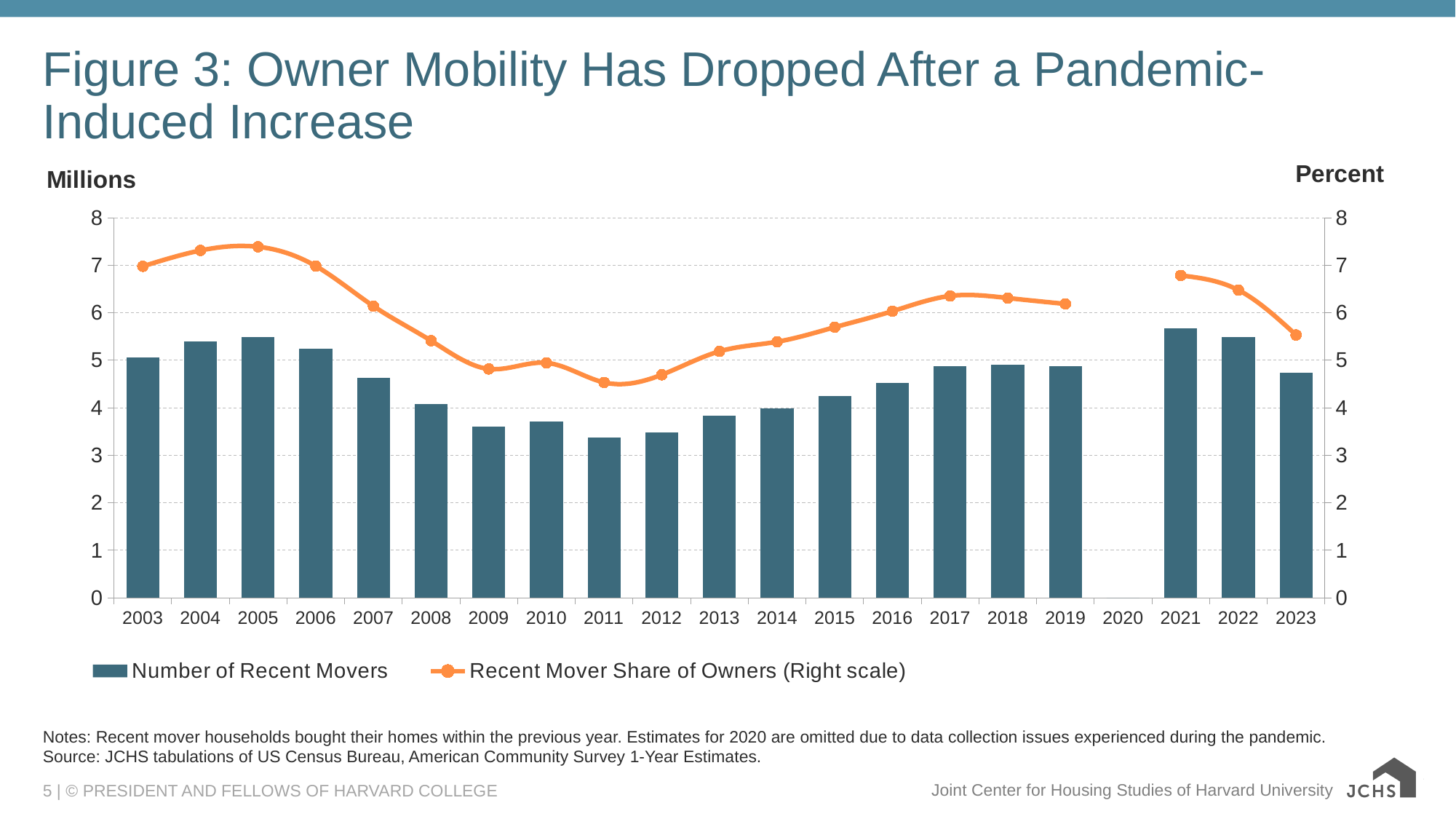
What kind of chart is shown on the slide? A combination bar and line chart Is the Number of Recent Movers in 2011 greater or less than 4 million? less How many years have a bar plotted for Number of Recent Movers? 20 Which year has the shortest bar for Number of Recent Movers? 2011 How many series does the legend list? 2 Is the Number of Recent Movers in 2021 greater or less than 5 million? greater Which year has a larger Number of Recent Movers, 2003 or 2023? 2003 Which year has a higher Recent Mover Share of Owners, 2008 or 2016? 2016 Does the Recent Mover Share of Owners rise or fall from 2021 to 2023? Fall Is the Recent Mover Share of Owners in 2023 greater or less than 6 percent? less Which year has the tallest bar for Number of Recent Movers? 2021 In which year is the Recent Mover Share of Owners line at its lowest point? 2011